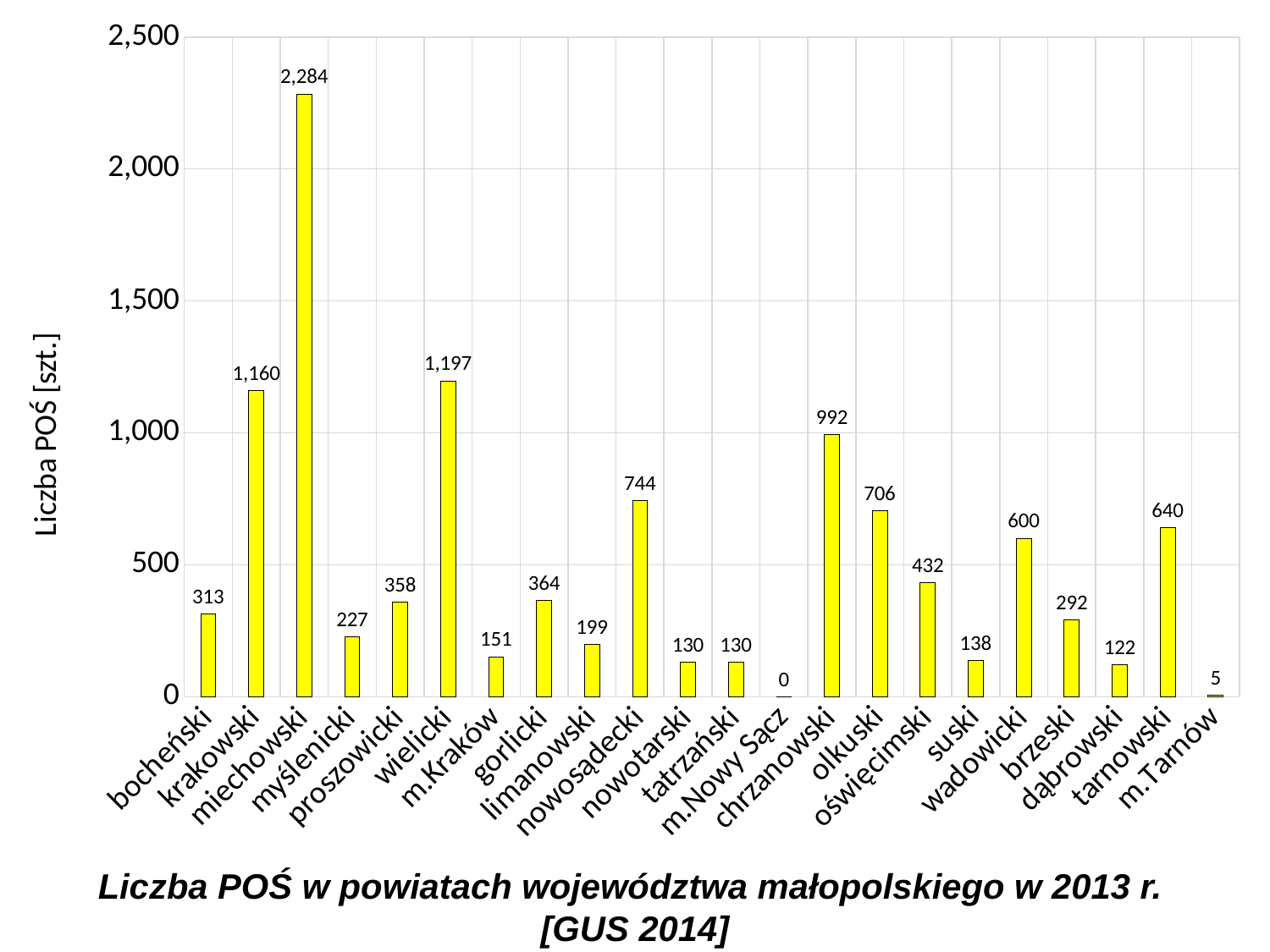
What is the difference between the values for wielicki and krakowski? 37 What is the value for miechowski? 2,284 What is the value for chrzanowski? 992 Which is larger, the value for nowosądecki or the value for olkuski? nowosądecki What is the label of the y axis? Liczba POŚ [szt.] How many powiats are shown on the x axis? 22 What is the difference between the values for olkuski and tarnowski? 66 Which powiat has the highest number of POŚ? miechowski Which powiat has the lowest number of POŚ? m.Nowy Sącz What kind of chart is shown on the slide? bar chart What is the value for m.Tarnów? 5 Is the value for wadowicki greater or less than 500? greater